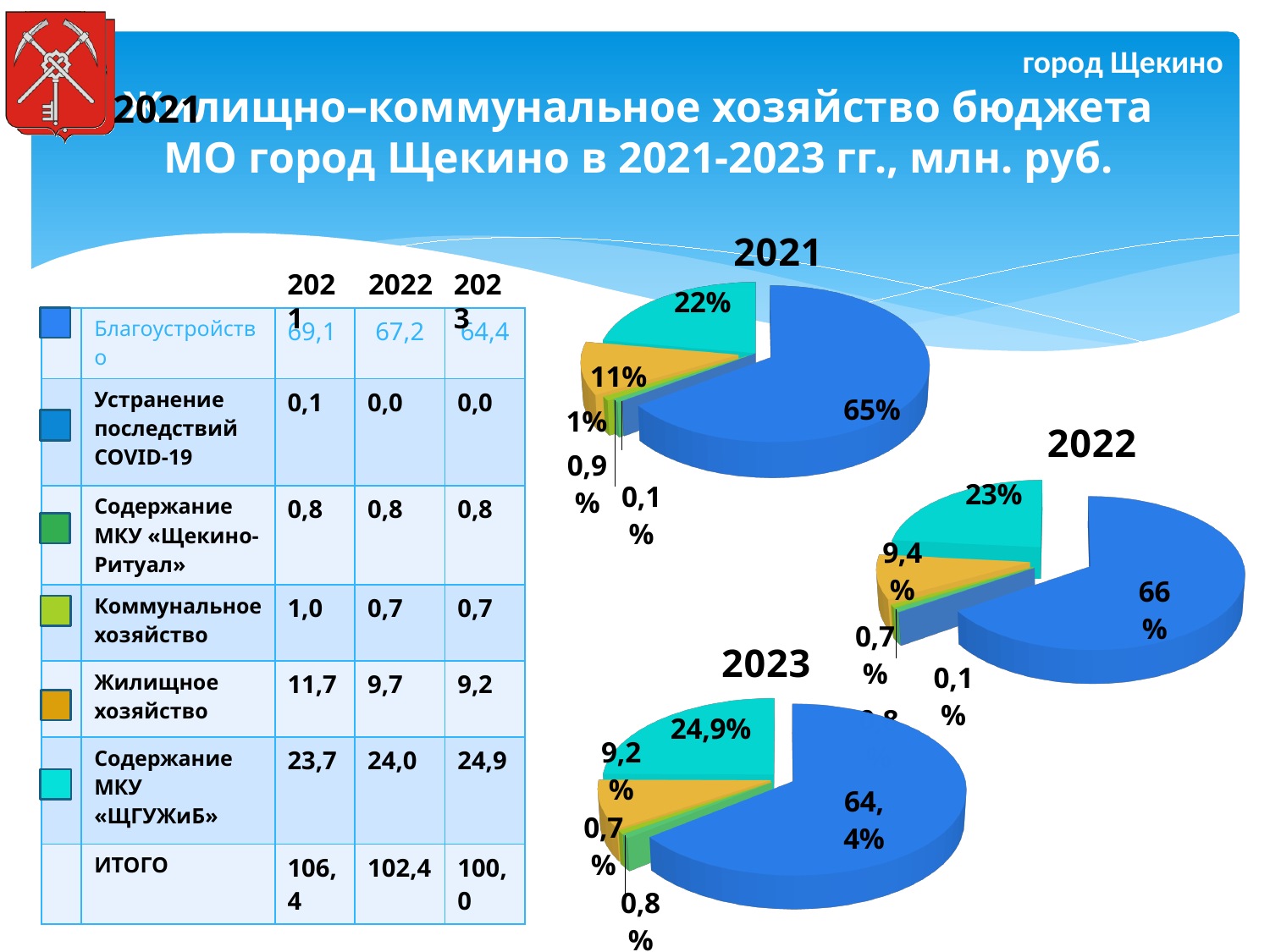
Which is larger: the largest slice in the 2021 pie chart or the largest slice in the 2023 pie chart? 2021 (65%) In the 2021 pie chart, what is the share of the largest slice? 65% What is the title of the pie chart at the top right of the slide? 2021 In the 2022 pie chart, what is the share of the largest slice? 66% How many pie charts are on the slide? 3 In the 2023 pie chart, what share is shown for the cyan (turquoise) slice? 24,9% In the 2023 pie chart, what is the difference between the largest slice (64,4%) and the cyan slice (24,9%)? 39,5% What type of charts are shown on the slide? pie charts In the 2022 pie chart, what share is shown for the orange slice? 9,4% In the 2021 pie chart, what share is shown for the cyan (turquoise) slice? 22% In the 2023 pie chart, what is the share of the largest slice? 64,4%